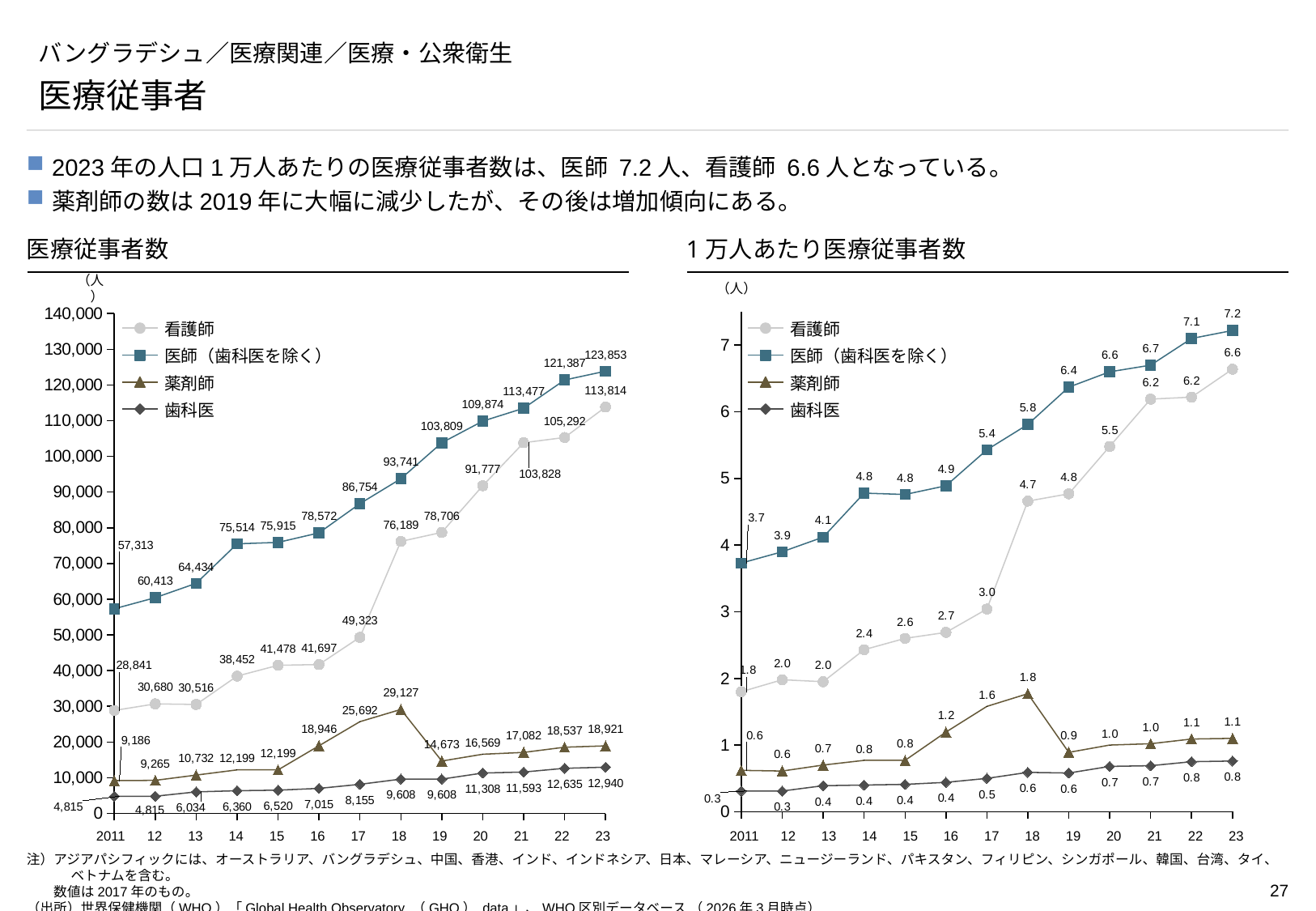
In the 医療従事者数 chart on the left, how many series does the legend list? 4 In the 医療従事者数 chart on the left, in which year does the 薬剤師 series reach its highest value? 2018 In the 1万人あたり医療従事者数 chart on the right, how many years are plotted along the x axis? 13 In the 1万人あたり医療従事者数 chart on the right, what is the difference between the 医師（歯科医を除く） value and the 看護師 value in 2011? 1.9 In the 医療従事者数 chart on the left, what is the value for 医師（歯科医を除く） in 2023? 123,853 In the 1万人あたり医療従事者数 chart on the right, what is the value for 看護師 in 2023? 6.6 In the 医療従事者数 chart on the left, what is the value for 看護師 in 2018? 76,189 In the 1万人あたり医療従事者数 chart on the right, does the 医師（歯科医を除く） series generally rise or fall from 2011 to 2023? Rise In the 医療従事者数 chart on the left, what is the difference between the 医師（歯科医を除く） value and the 看護師 value in 2023? 10,039 What kind of chart is the 1万人あたり医療従事者数 chart on the right? Line chart In the 医療従事者数 chart on the left, which is larger in 2021: 薬剤師 or 歯科医? 薬剤師 In the 1万人あたり医療従事者数 chart on the right, what is the value for 薬剤師 in 2019? 0.9